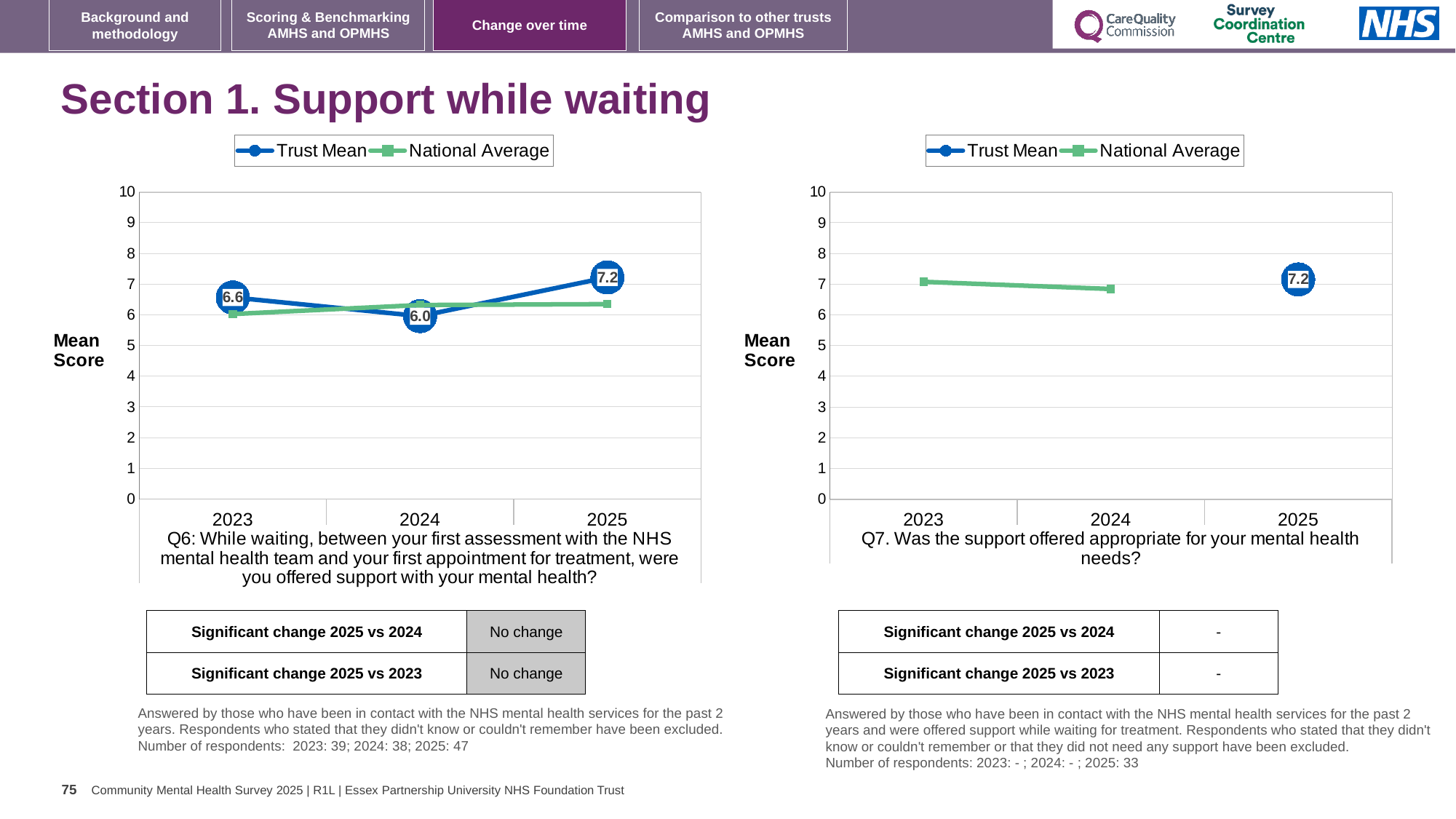
On the Q7 chart (right), what is the Trust Mean for 2025? 7.2 On the Q6 chart (left), which year has the lowest Trust Mean? 2024 What kind of chart is the Q7 chart (right)? line chart On the Q7 chart (right), is the National Average for 2024 greater or less than 8? less On the Q6 chart (left), which year has the highest Trust Mean? 2025 How many series does the legend of the Q6 chart (left) list? 2 On the Q6 chart (left), what is the Trust Mean for 2024? 6.0 On the Q6 chart (left), what is the Trust Mean for 2023? 6.6 On the Q6 chart (left), is the Trust Mean for 2023 larger or smaller than the Trust Mean for 2024? larger On the Q7 chart (right), does the National Average rise or fall from 2023 to 2024? fall On the Q6 chart (left), what is the Trust Mean for 2025? 7.2 On the Q6 chart (left), what is the difference between the Trust Mean for 2025 and the Trust Mean for 2024? 1.2